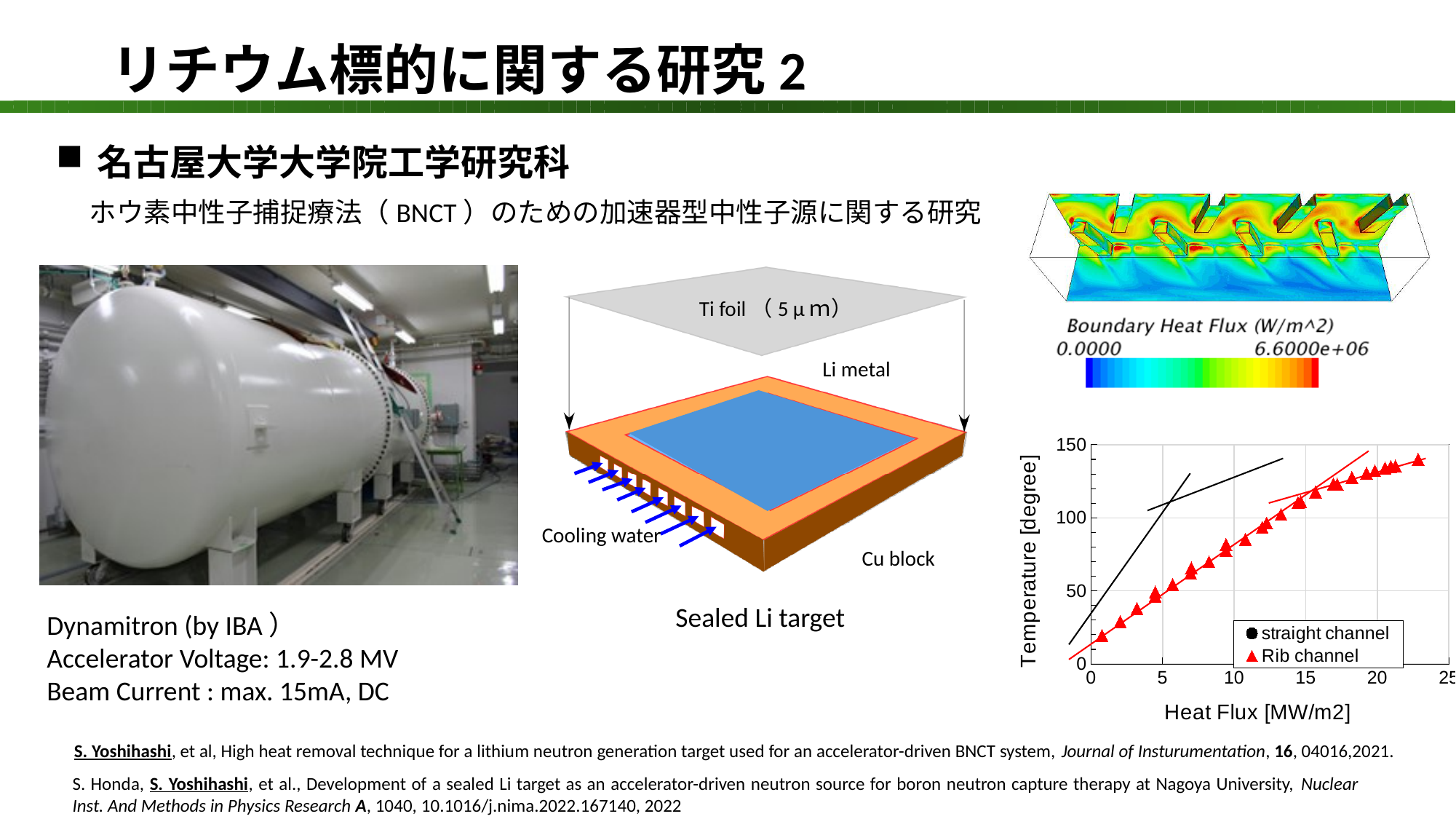
In the Temperature vs Heat Flux chart, is the Rib channel temperature at a heat flux of 10 MW/m2 greater or less than 100 degrees? less What are the two series named in the legend of the Temperature vs Heat Flux chart? straight channel and Rib channel In the Temperature vs Heat Flux chart, at a heat flux of 5 MW/m2, which series shows the higher temperature, straight channel or Rib channel? straight channel What kind of chart is the Temperature vs Heat Flux chart on the right of the slide? scatter chart What is the label of the x axis of the Temperature vs Heat Flux chart? Heat Flux [MW/m2] In the Temperature vs Heat Flux chart, is the Rib channel temperature at a heat flux of 10 MW/m2 greater or less than 50 degrees? greater In the Temperature vs Heat Flux chart, is the Rib channel temperature at a heat flux of 20 MW/m2 greater or less than 100 degrees? greater How many series does the legend of the Temperature vs Heat Flux chart list? 2 In the Temperature vs Heat Flux chart, does the Rib channel temperature rise or fall as heat flux increases? rise In the Temperature vs Heat Flux chart, which series reaches a heat flux above 20 MW/m2? Rib channel What is the highest value shown on the y axis of the Temperature vs Heat Flux chart? 150